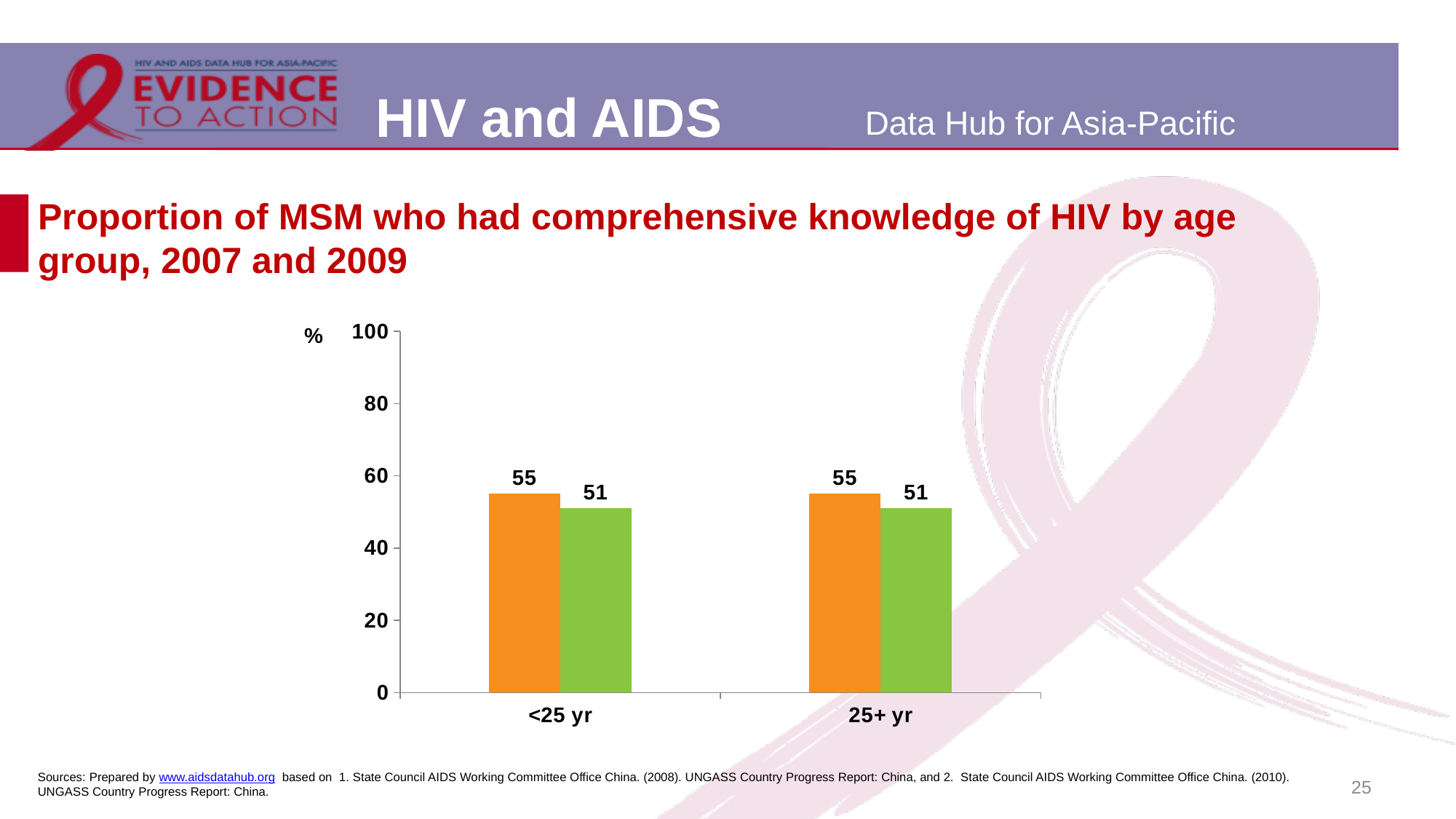
What is the difference between the orange and green bars for the 25+ yr age group? 4 What is the value of the orange bar for the <25 yr age group? 55 What is the value of the orange bar for the 25+ yr age group? 55 How many age group categories are shown on the x axis? 2 What type of chart is shown on the slide? bar chart What is the value of the green bar for the 25+ yr age group? 51 For the 25+ yr age group, which bar is larger, the orange or the green? orange What is the value of the green bar for the <25 yr age group? 51 What is the difference between the orange and green bars for the <25 yr age group? 4 Is the value of the green bar for the <25 yr age group greater or less than 60? less What unit is shown on the y axis of the chart? % What is the maximum value shown on the y axis? 100